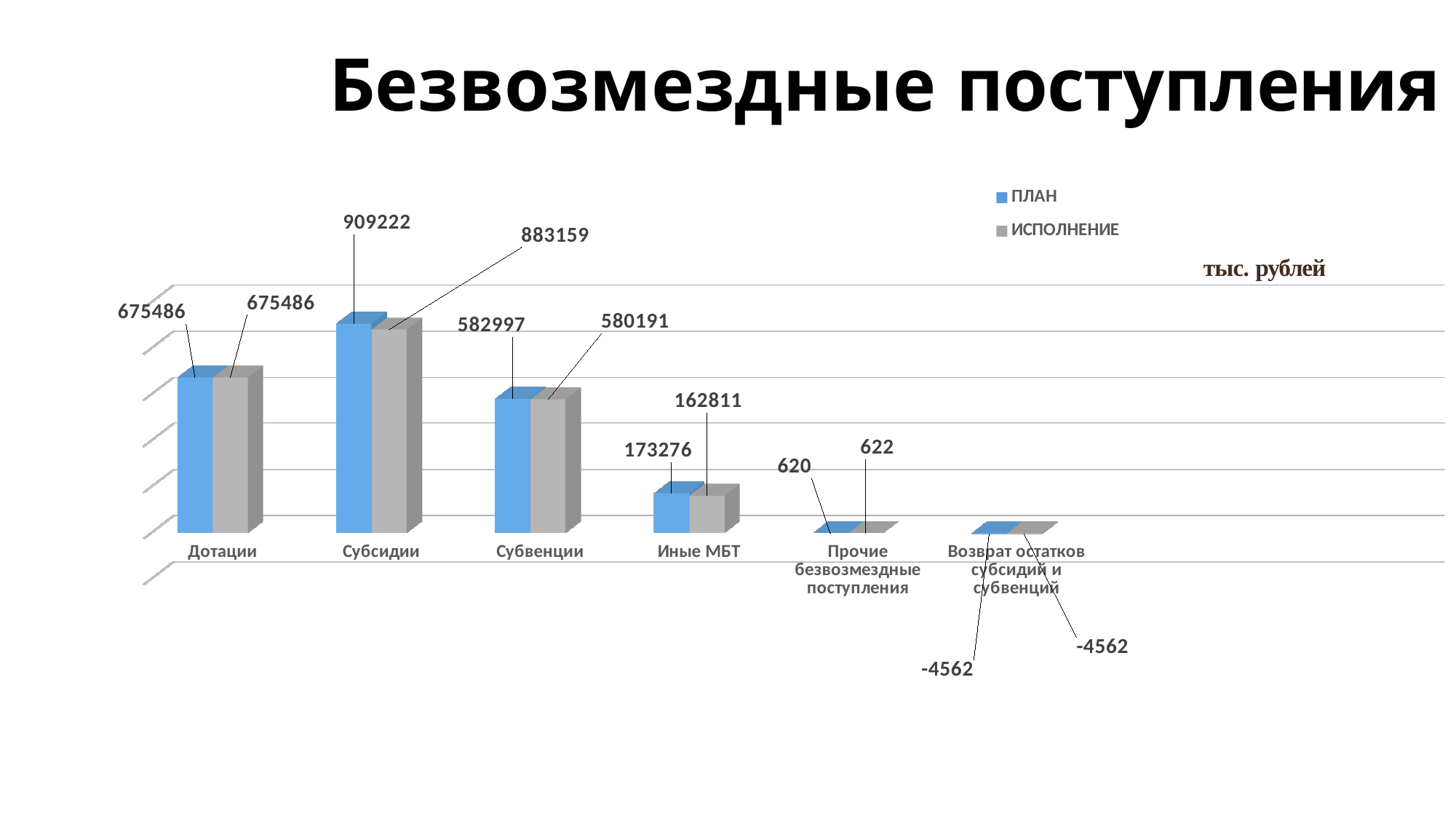
What is the ИСПОЛНЕНИЕ value for Иные МБТ? 162811 Which category has the highest ПЛАН value? Субсидии What is the difference between the ПЛАН and ИСПОЛНЕНИЕ values for Субсидии? 26063 What is the ИСПОЛНЕНИЕ value for Субвенции? 580191 Which is larger for Иные МБТ: the ПЛАН value or the ИСПОЛНЕНИЕ value? ПЛАН What kind of chart is shown on the slide? Bar chart What is the ПЛАН value for Прочие безвозмездные поступления? 620 What is the ИСПОЛНЕНИЕ value for Возврат остатков субсидий и субвенций? -4562 How many series does the legend list? 2 Which category has the lowest ИСПОЛНЕНИЕ value? Возврат остатков субсидий и субвенций What is the ПЛАН value for Субсидии? 909222 How many categories are shown on the x axis? 6